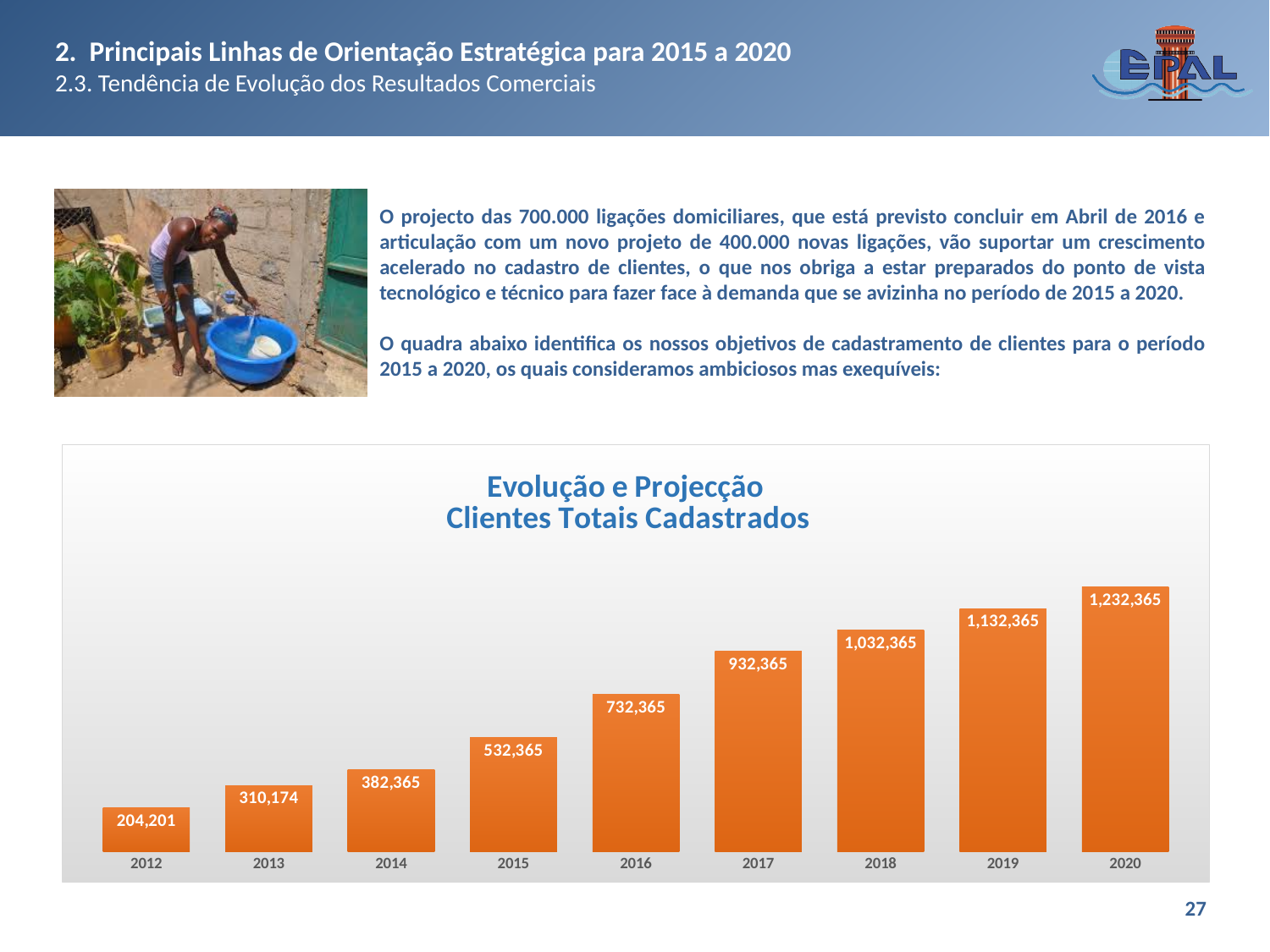
What is the value for 2020? 1,232,365 What is the difference between the values for 2020 and 2019? 100,000 What is the value for 2012? 204,201 Do the values rise or fall from 2012 to 2020? rise Which is larger, the value for 2015 or the value for 2014? 2015 What is the difference between the values for 2013 and 2012? 105,973 How many years are shown on the x axis? 9 Which year has the lowest value? 2012 Which year has the highest value? 2020 What is the value for 2016? 732,365 What is the title of the chart? Evolução e Projecção Clientes Totais Cadastrados What kind of chart is this? bar chart